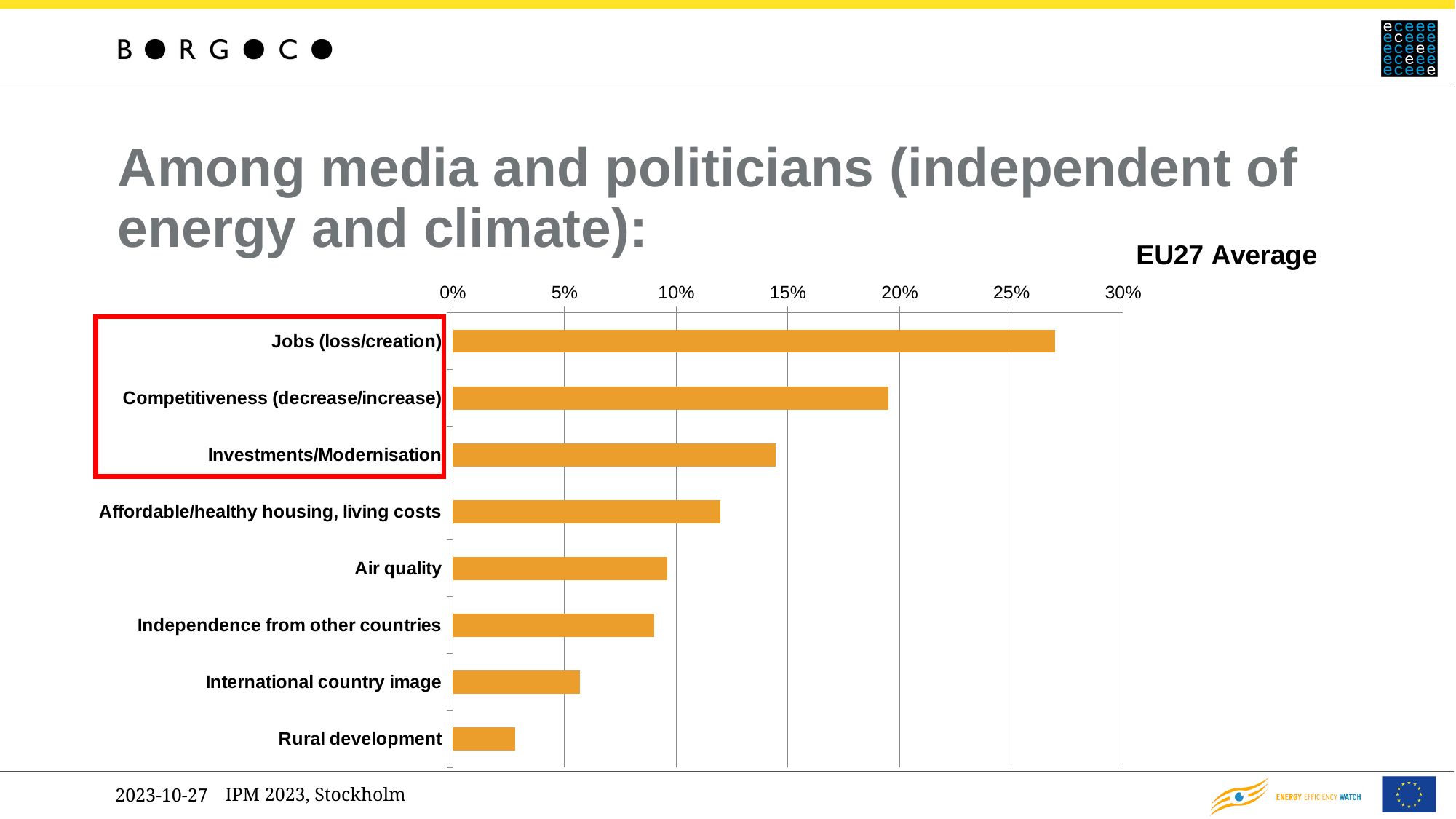
Which is larger, the value for Air quality or the value for International country image? Air quality What label appears above the chart's value axis on the right? EU27 Average Is the value for Rural development greater or less than 5%? less Is the value for Jobs (loss/creation) greater or less than 25%? greater Which category has the lowest value in the chart? Rural development Is the value for Investments/Modernisation greater or less than 15%? less Which category has the highest value in the chart? Jobs (loss/creation) Which is larger, the value for Competitiveness (decrease/increase) or the value for Investments/Modernisation? Competitiveness (decrease/increase) How many categories are plotted in the chart? 8 What kind of chart is shown on the slide? bar chart